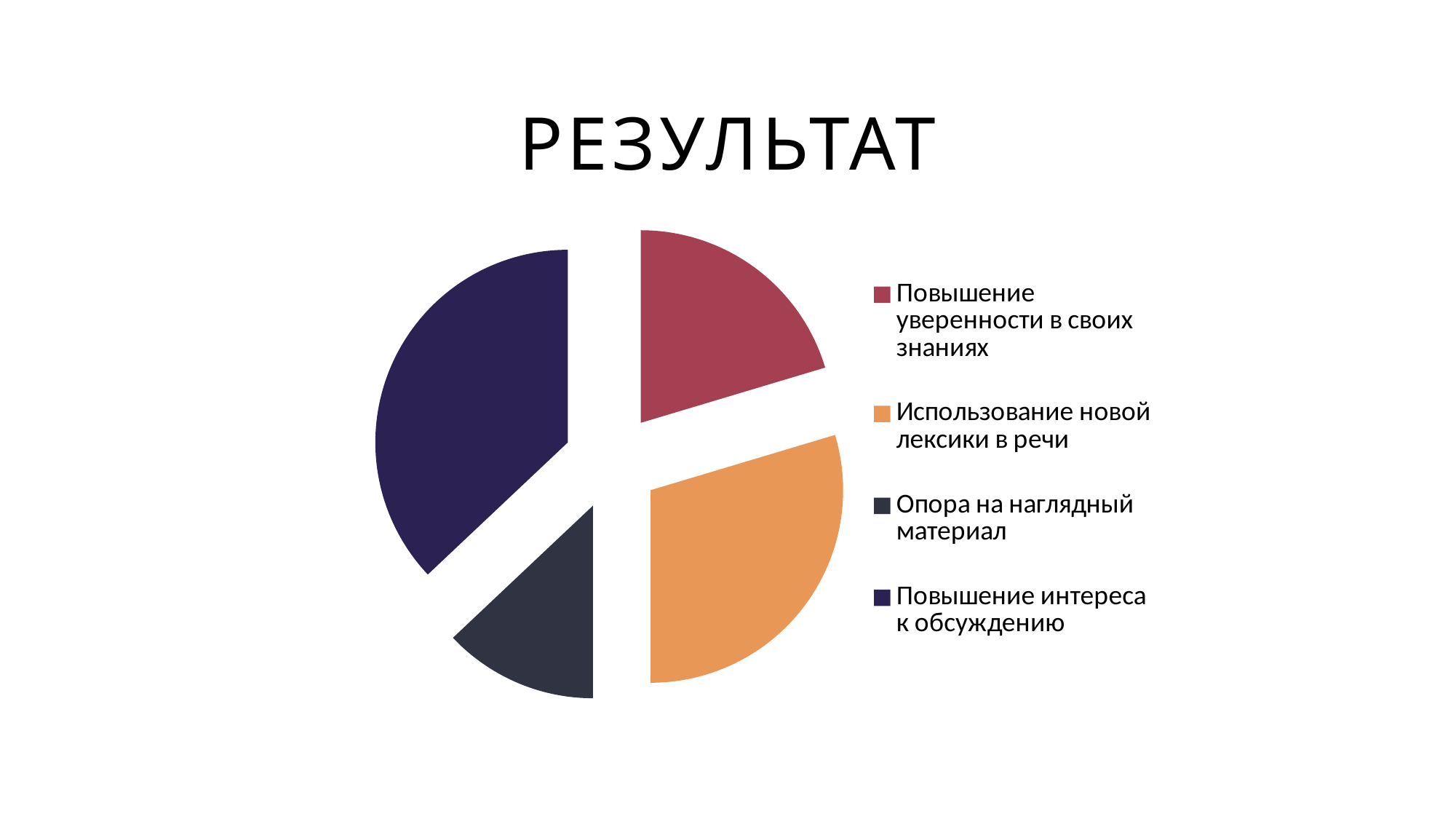
How many slices does the pie chart have? 4 What colour is the slice for "Использование новой лексики в речи"? orange What kind of chart is shown on the slide? pie chart Which slice is larger: "Повышение интереса к обсуждению" or "Опора на наглядный материал"? Повышение интереса к обсуждению How many entries does the legend of the pie chart list? 4 What is the title of the slide with the pie chart? РЕЗУЛЬТАТ Which category has the largest slice in the pie chart? Повышение интереса к обсуждению Which slice is larger: "Использование новой лексики в речи" or "Повышение уверенности в своих знаниях"? Использование новой лексики в речи Which category has the smallest slice in the pie chart? Опора на наглядный материал